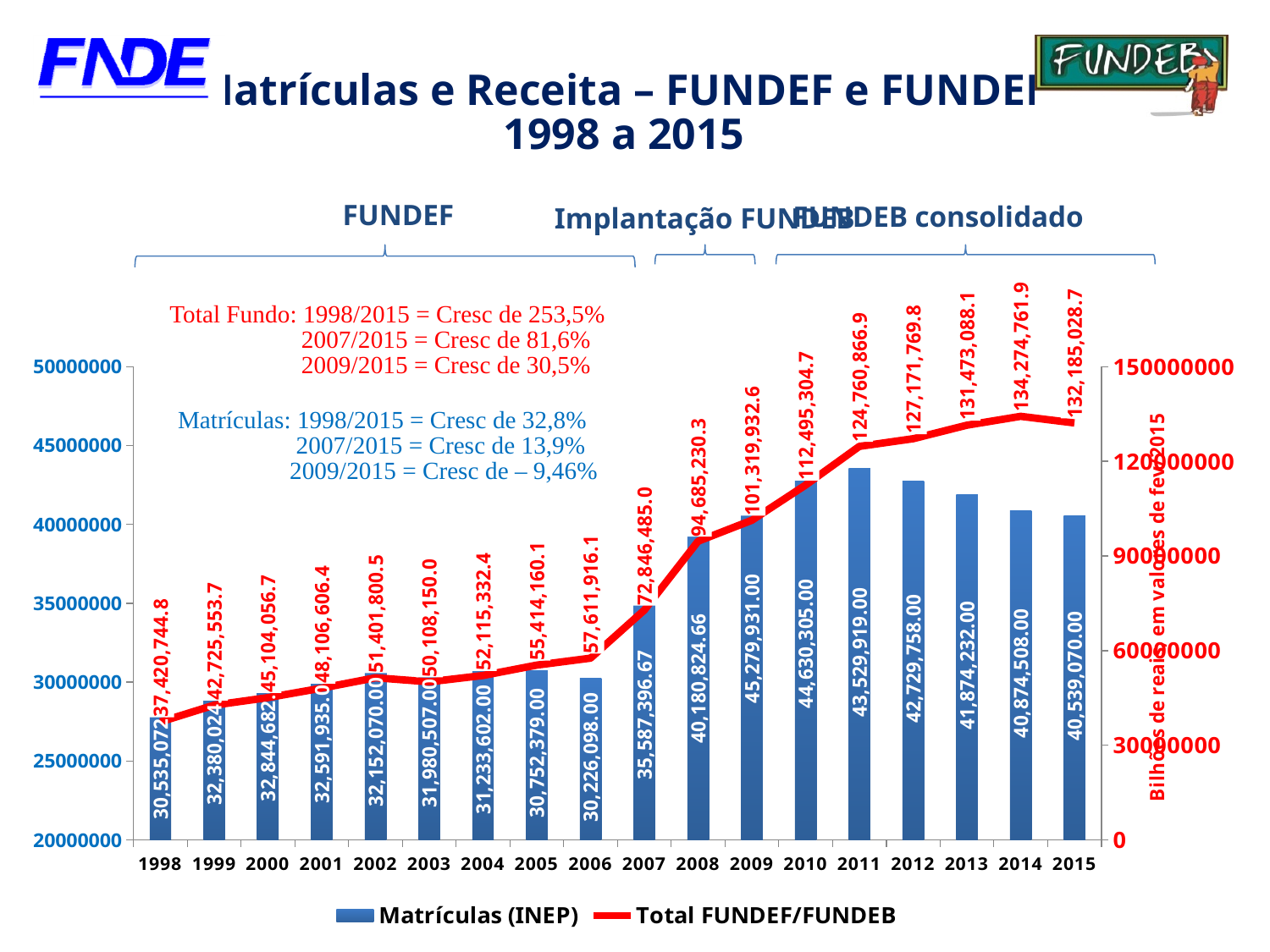
What is the value of Matrículas (INEP) for 2015? 40,539,070.00 How many years are shown on the x axis? 18 How many series does the legend list? 2 In which year is Matrículas (INEP) highest? 2009 What is the difference between Total FUNDEF/FUNDEB in 2015 and in 2014? 2,089,733.2 What is the value of Total FUNDEF/FUNDEB for 2007? 72,846,485.0 In which year is Total FUNDEF/FUNDEB lowest? 1998 In which year is Total FUNDEF/FUNDEB highest? 2014 Does Total FUNDEF/FUNDEB generally rise or fall from 1998 to 2014? rise What is the value of Total FUNDEF/FUNDEB for 2014? 134,274,761.9 What is the value of Matrículas (INEP) for 2009? 45,279,931.00 Which year has the larger Matrículas (INEP) value, 2006 or 2010? 2010